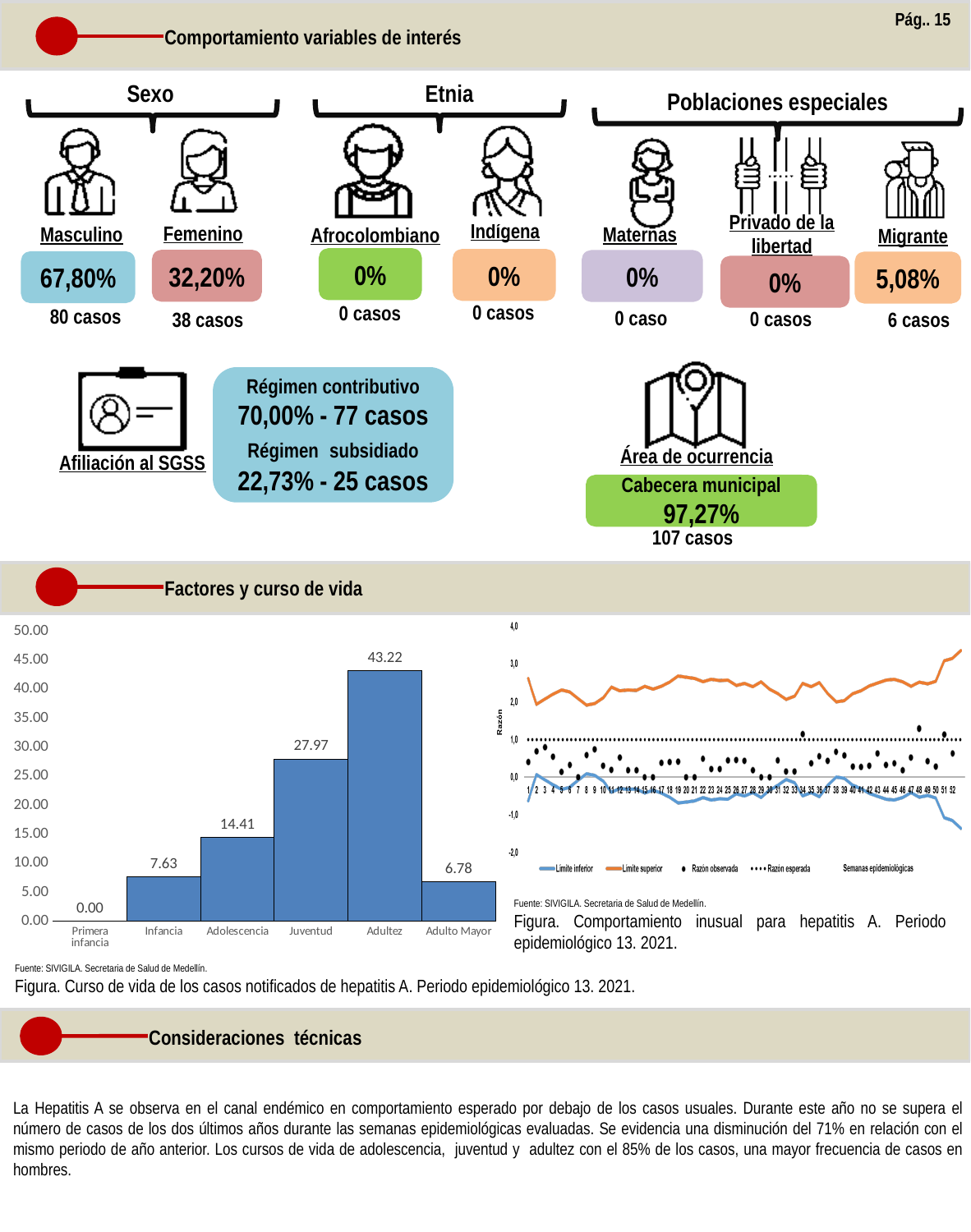
In the bar chart 'Curso de vida de los casos notificados de hepatitis A', which is larger, Adolescencia or Adulto Mayor? Adolescencia In the bar chart 'Curso de vida de los casos notificados de hepatitis A', what is the value for Adulto Mayor? 6.78 What kind of chart is the 'Curso de vida de los casos notificados de hepatitis A' figure? bar chart In the bar chart 'Curso de vida de los casos notificados de hepatitis A', what is the value for Adultez? 43.22 How many categories are shown in the bar chart 'Curso de vida de los casos notificados de hepatitis A'? 6 In the bar chart 'Curso de vida de los casos notificados de hepatitis A', what is the difference between the values for Adultez and Juventud? 15.25 In the 'Comportamiento inusual para hepatitis A' chart, is the Límite superior value at week 52 greater or less than 3,0? greater What kind of chart is the 'Comportamiento inusual para hepatitis A' figure on the right? line chart In the bar chart 'Curso de vida de los casos notificados de hepatitis A', what is the value for Infancia? 7.63 In the bar chart 'Curso de vida de los casos notificados de hepatitis A', which category has the lowest value? Primera infancia In the 'Comportamiento inusual para hepatitis A' chart, what is the label of the y axis? Razón In the bar chart 'Curso de vida de los casos notificados de hepatitis A', which category has the highest value? Adultez